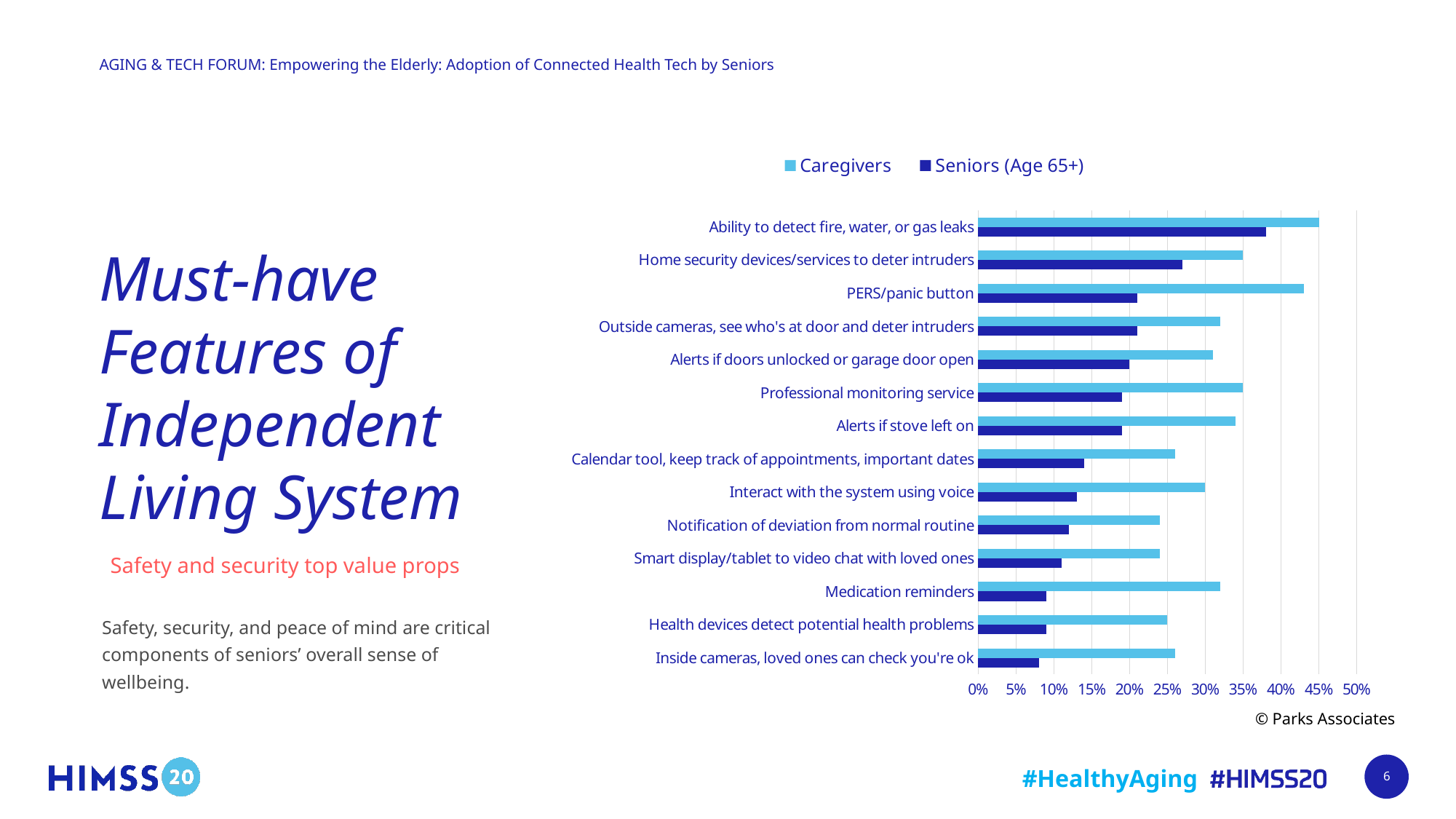
Which feature has the highest value for Seniors (Age 65+)? Ability to detect fire, water, or gas leaks For 'Medication reminders', which series has the larger value, Caregivers or Seniors (Age 65+)? Caregivers Is the Seniors (Age 65+) value for 'PERS/panic button' greater or less than 25%? less Is the Caregivers value for 'Ability to detect fire, water, or gas leaks' greater or less than 40%? greater Which feature has the highest value for Caregivers? Ability to detect fire, water, or gas leaks How many feature categories are plotted on the chart? 14 Is the Seniors (Age 65+) value for 'Medication reminders' greater or less than 15%? less How many series does the chart legend list? 2 What kind of chart is shown on the slide? bar chart Which series is shown in the lighter blue colour in the chart? Caregivers For Caregivers, which is larger: 'PERS/panic button' or 'Home security devices/services to deter intruders'? PERS/panic button